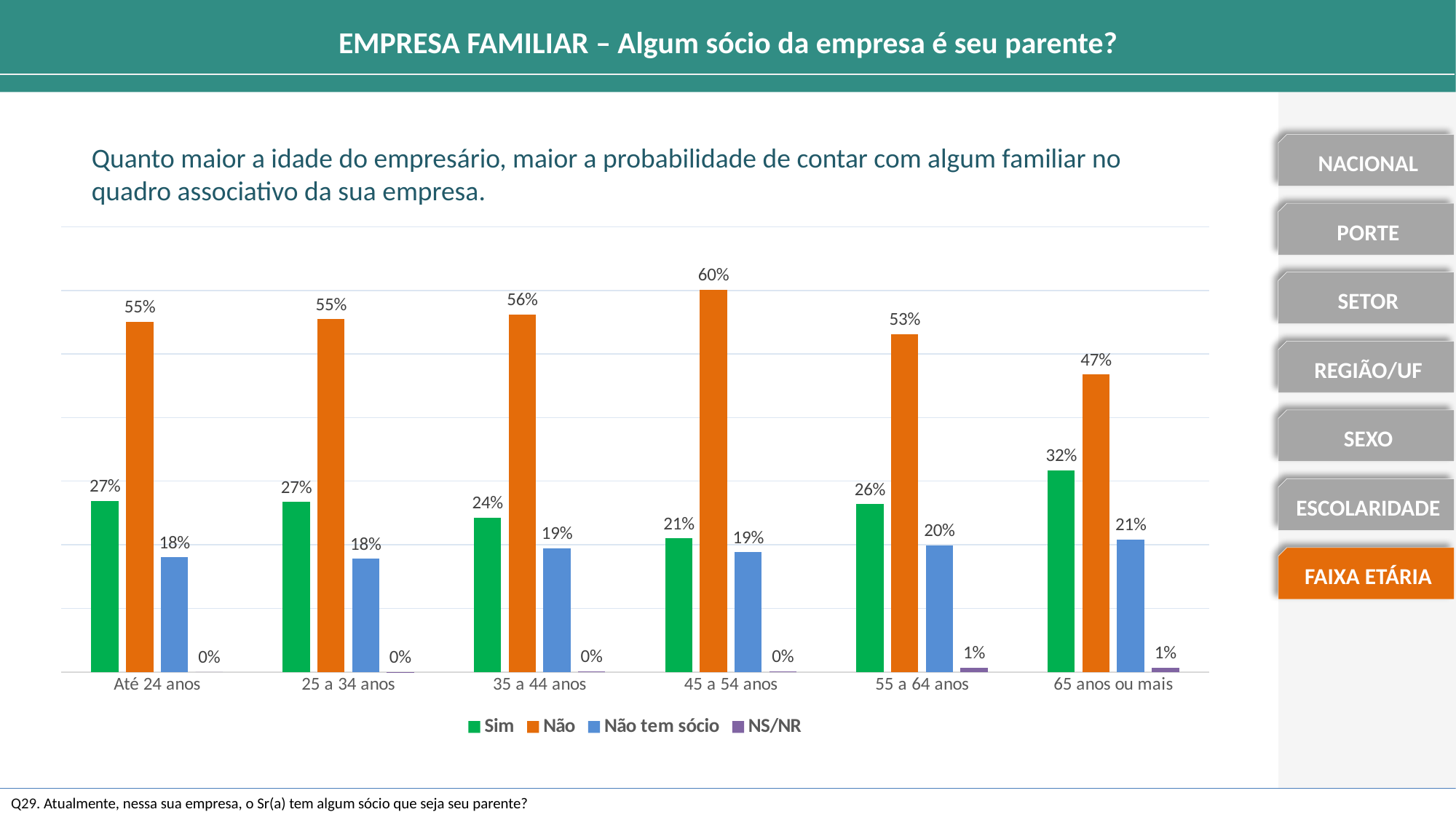
Which age category has the lowest value for "Sim"? 45 a 54 anos How many age categories are shown on the x axis? 6 How many series does the legend list? 4 Which is larger in the "35 a 44 anos" category: "Sim" or "Não tem sócio"? Sim Does the "Sim" value rise or fall from "55 a 64 anos" to "65 anos ou mais"? Rise Which colour represents the "Não" series in the legend? Orange What is the value for "Sim" in the "65 anos ou mais" category? 32% What is the value for "Não" in the "45 a 54 anos" category? 60% What kind of chart is shown on the slide? Bar chart What is the difference between the "Não" and "Sim" values in the "65 anos ou mais" category? 15% Which age category has the highest value for "Não"? 45 a 54 anos What is the value for "Não tem sócio" in the "55 a 64 anos" category? 20%